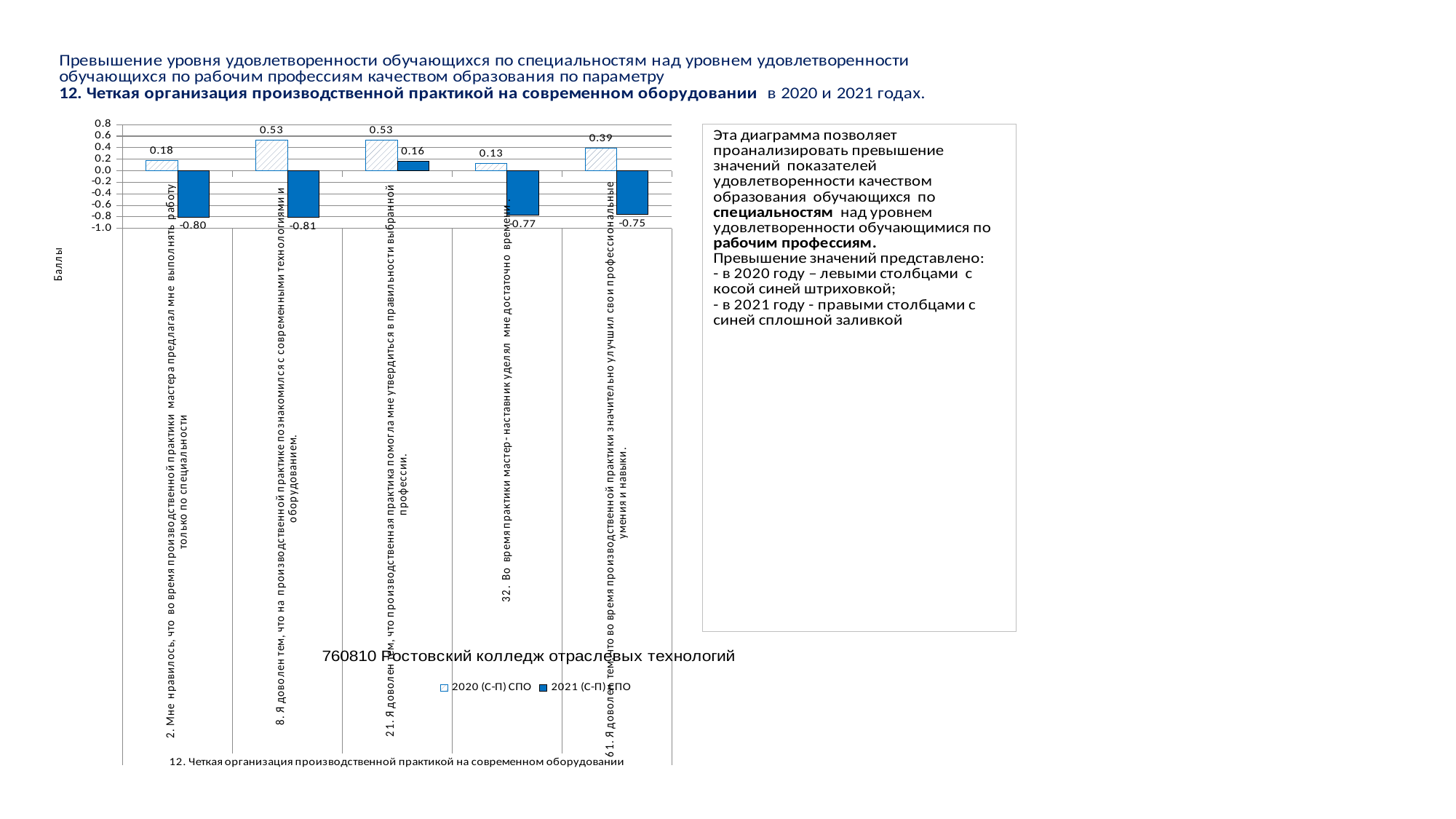
How many series does the chart legend list? 2 Which category has the lowest 2020 (С-П) СПО value? 32. Во время практики мастер-наставник уделял мне достаточно времени What type of chart is shown on the slide? Bar chart Which category has the highest 2021 (С-П) СПО value? 21. Я доволен тем, что производственная практика помогла мне утвердиться в правильности выбранной профессии How many categories are shown on the x axis of the chart? 5 What is the label of the vertical axis of the chart? Баллы What is the difference between the 2020 and 2021 values for category 2? 0.98 What is the 2021 (С-П) СПО value for category 21 ("Я доволен тем, что производственная практика помогла мне утвердиться в правильности выбранной профессии")? 0.16 Which is larger for category 32: the 2020 (С-П) СПО value or the 2021 (С-П) СПО value? 2020 (С-П) СПО What is the 2020 (С-П) СПО value for category 61 ("Я доволен тем, что во время производственной практики значительно улучшил свои профессиональные умения и навыки")? 0.39 What is the 2020 (С-П) СПО value for category 2 ("Мне нравилось, что во время производственной практики мастера предлагал мне выполнять работу только по специальности")? 0.18 What is the 2021 (С-П) СПО value for category 8 ("Я доволен тем, что на производственной практике познакомился с современными технологиями и оборудованием")? -0.81